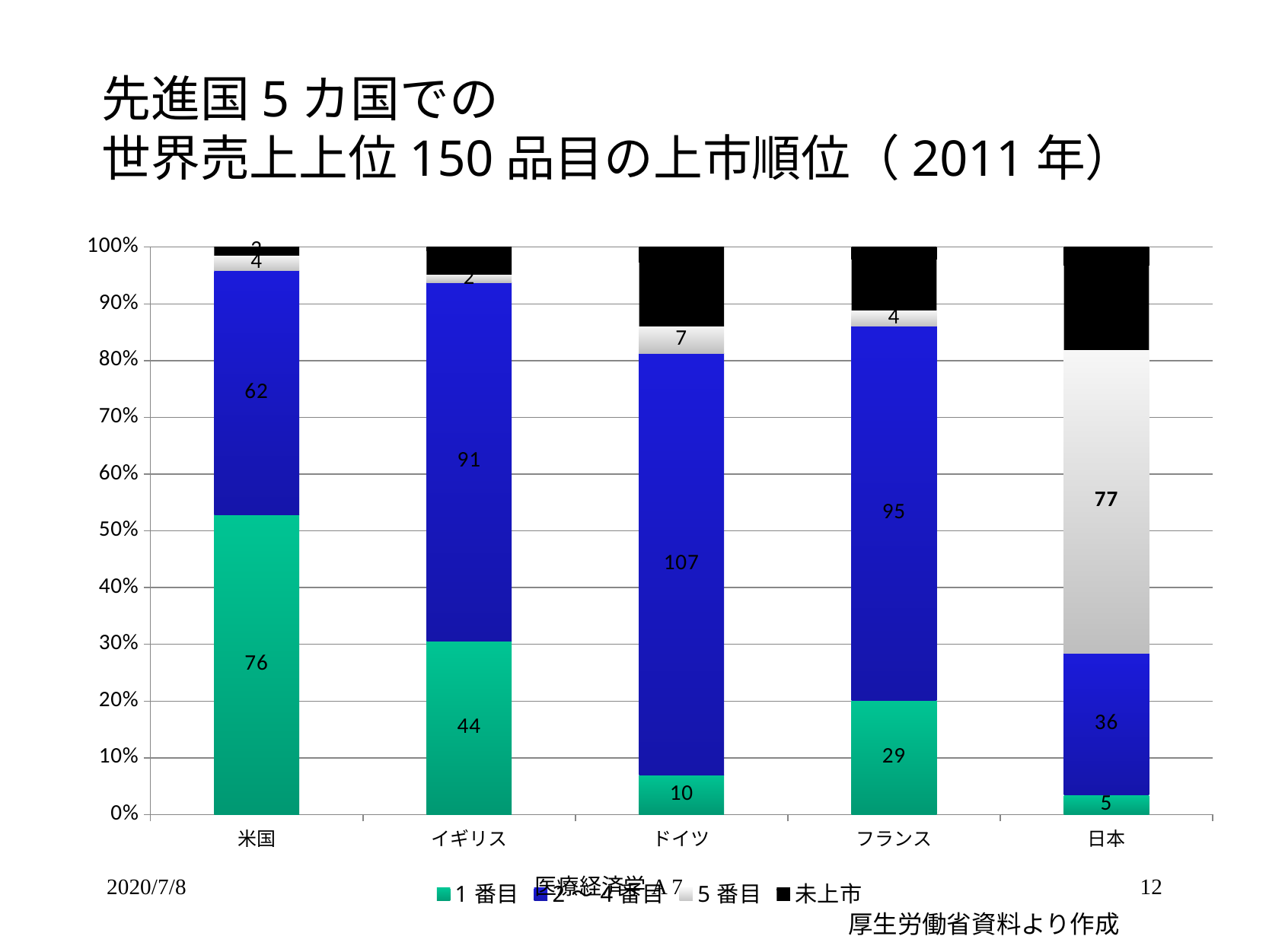
Which country has the highest value for the 1番目 series? 米国 How many countries are shown on the x axis? 5 What is the value of the 5番目 segment for ドイツ? 7 What is the value of the 2～4番目 segment for ドイツ? 107 Which country has the lowest value for the 1番目 series? 日本 Which has the larger 2～4番目 value, イギリス or フランス? フランス What is the value of the 1番目 segment for 米国? 76 What is the value of the 5番目 segment for 日本? 77 Is the share of the 1番目 segment for ドイツ greater or less than 10%? less What is the value of the 1番目 segment for 日本? 5 How many series does the legend list? 4 What is the difference between the 1番目 values for 米国 and イギリス? 32